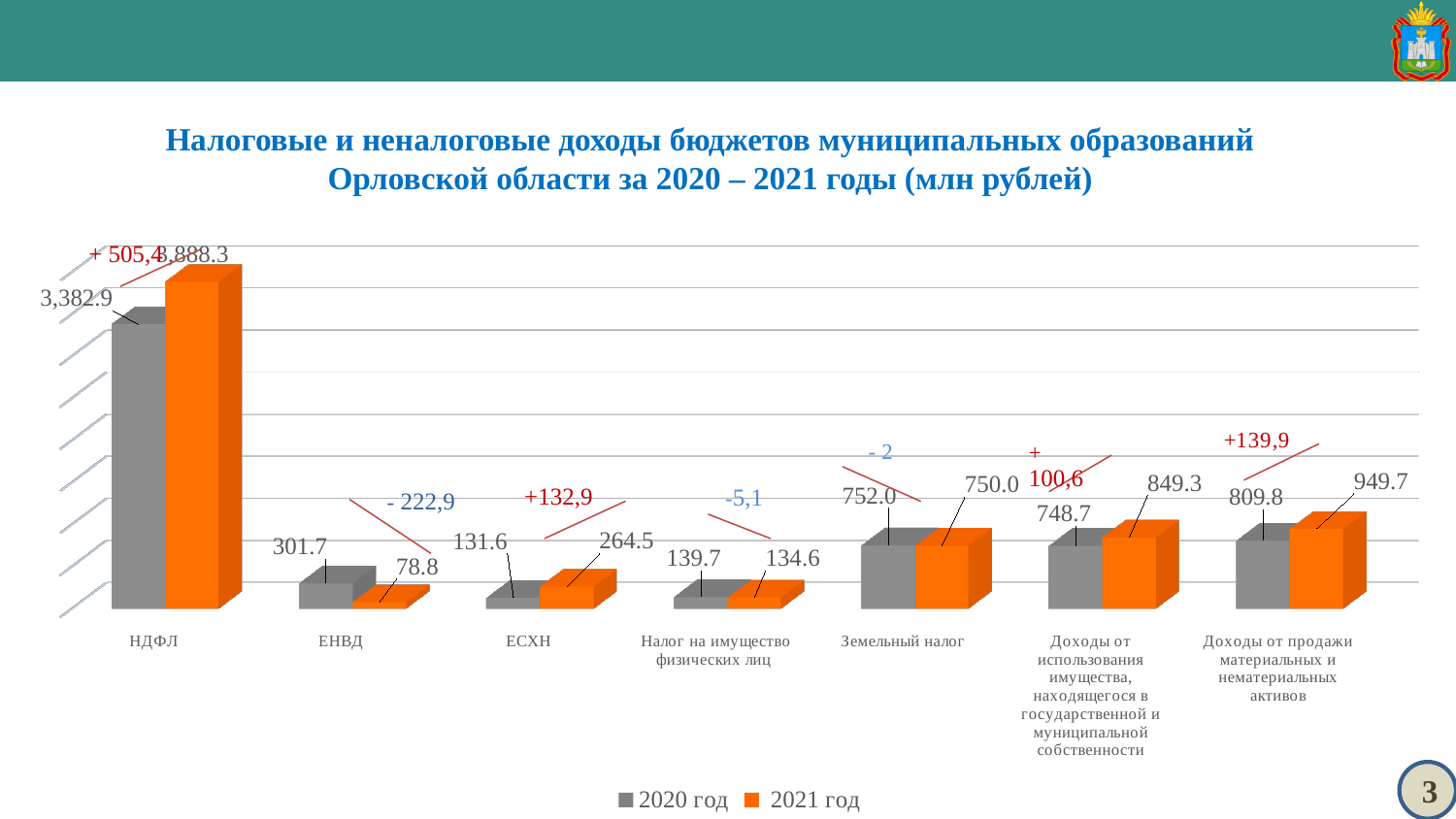
Which is larger for Налог на имущество физических лиц: the 2020 год value or the 2021 год value? 2020 год What is the value for Земельный налог in 2021 год? 750.0 What is the value for ЕСХН in 2021 год? 264.5 What type of chart is shown on the slide? Bar chart How many categories are shown on the x axis of the chart? 7 What is the value for Доходы от продажи материальных и нематериальных активов in 2020 год? 809.8 What is the difference between the 2021 год and 2020 год values for Доходы от использования имущества, находящегося в государственной и муниципальной собственности? 100.6 Which category has the lowest value in 2021 год? ЕНВД How many series does the legend list? 2 What is the value for ЕНВД in 2020 год? 301.7 Which colour represents the 2021 год series in the chart? Orange Which category has the highest value in 2021 год? НДФЛ